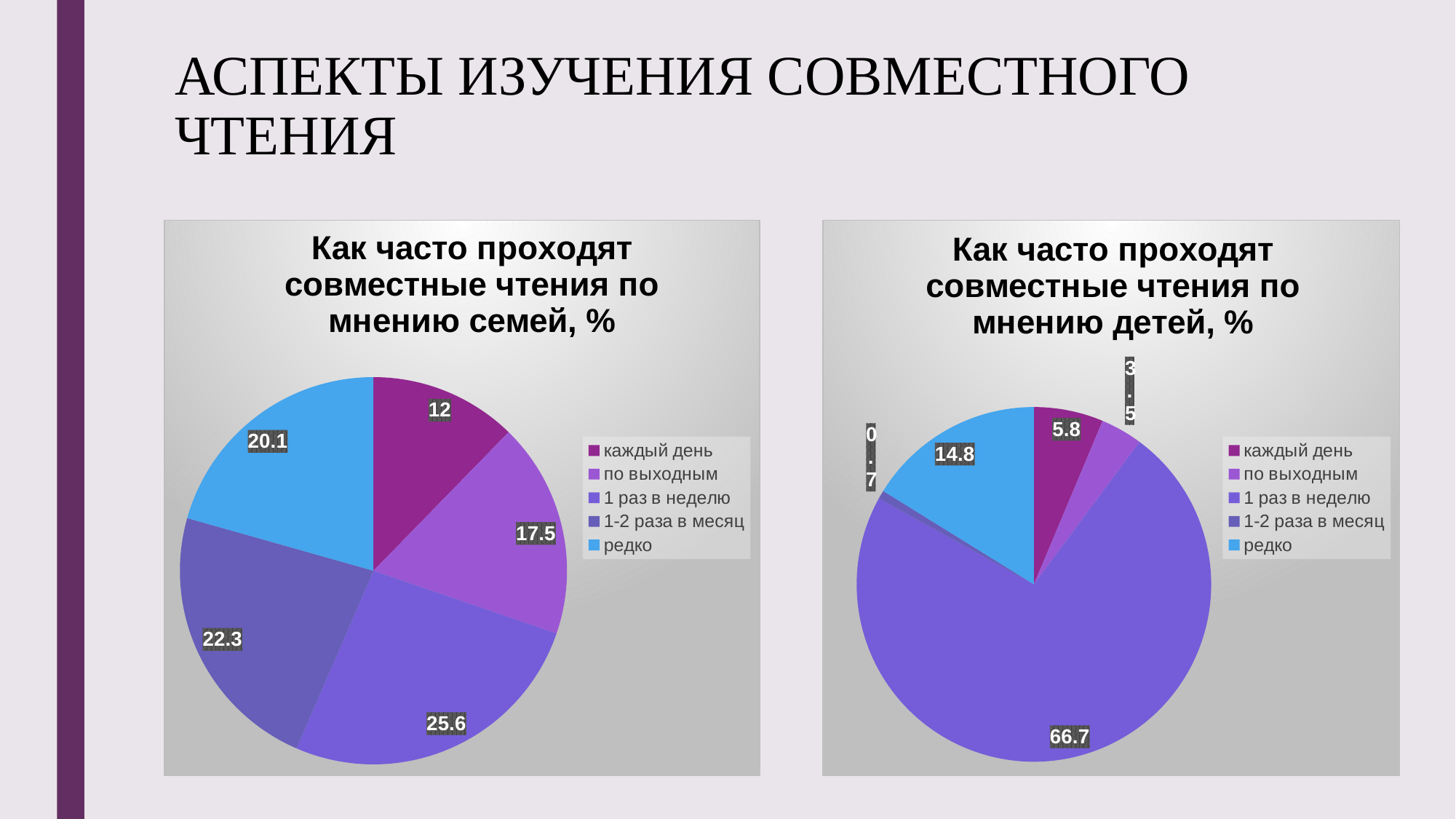
In the chart 'Как часто проходят совместные чтения по мнению детей, %', what is the difference between the values for 'каждый день' and 'по выходным'? 2.3 In the chart 'Как часто проходят совместные чтения по мнению детей, %', which category has the smallest slice? 1-2 раза в месяц In the chart 'Как часто проходят совместные чтения по мнению детей, %', what is the value for 'редко'? 14.8 In the chart 'Как часто проходят совместные чтения по мнению семей, %', what is the difference between the values for '1 раз в неделю' and 'редко'? 5.5 What type of chart is 'Как часто проходят совместные чтения по мнению детей, %'? Pie chart In the chart 'Как часто проходят совместные чтения по мнению семей, %', what is the value for '1-2 раза в месяц'? 22.3 In the chart 'Как часто проходят совместные чтения по мнению семей, %', which category has the largest slice? 1 раз в неделю In the chart 'Как часто проходят совместные чтения по мнению детей, %', which is larger: 'каждый день' or 'по выходным'? каждый день How many categories does the legend of the chart 'Как часто проходят совместные чтения по мнению семей, %' list? 5 In the chart 'Как часто проходят совместные чтения по мнению детей, %', what is the value for '1 раз в неделю'? 66.7 In the chart 'Как часто проходят совместные чтения по мнению семей, %', what is the value for 'каждый день'? 12 In the chart 'Как часто проходят совместные чтения по мнению семей, %', which category has the smallest slice? каждый день